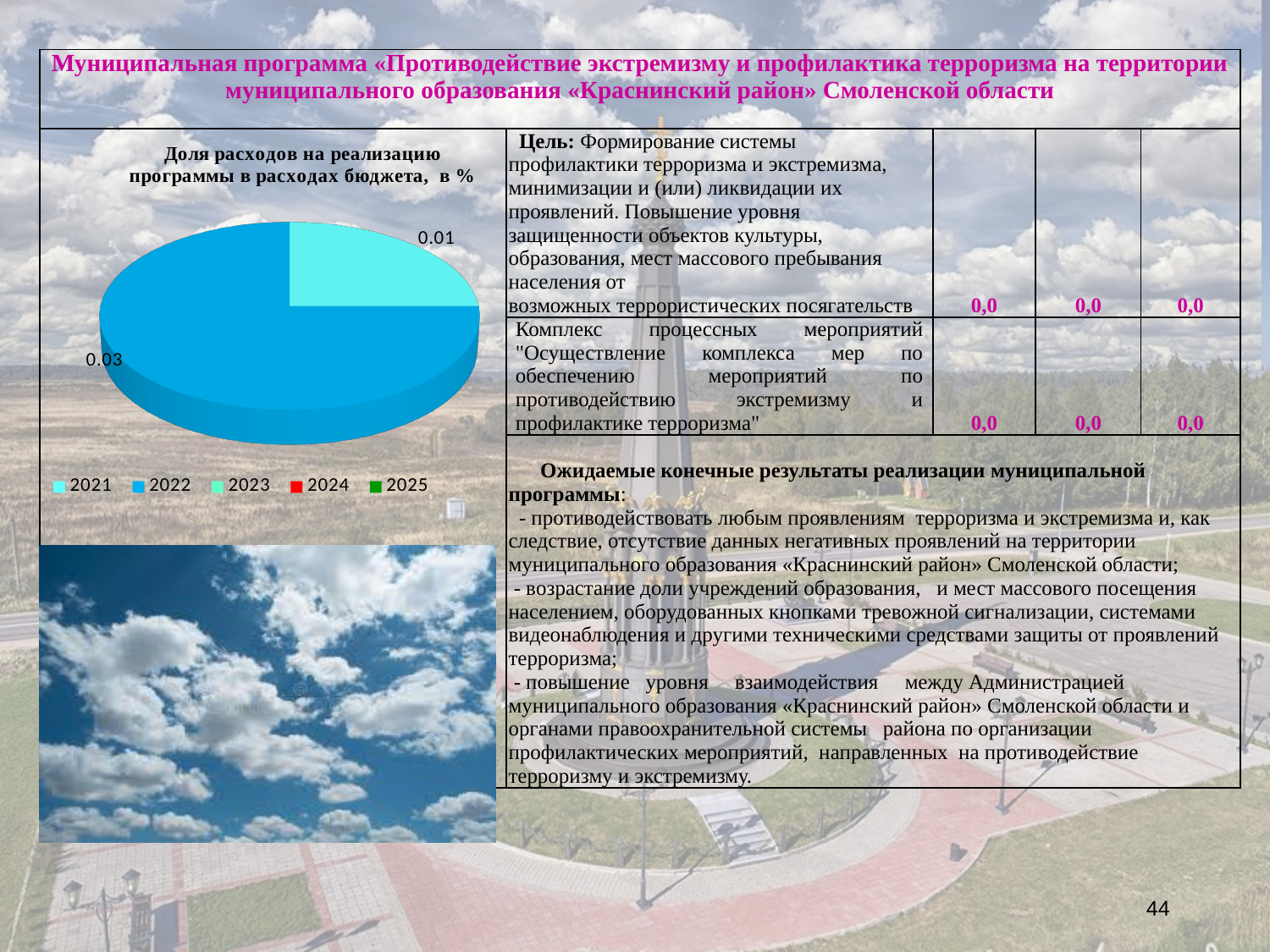
Which year has the largest slice in the pie chart? 2022 Which legend entry is shown in red in the pie chart legend? 2024 What kind of chart is shown on the slide? pie chart What value is shown for 2022 in the pie chart? 0.03 How many slices with data labels are visible in the pie chart? 2 What is the difference between the values for 2022 and 2021 in the pie chart? 0.02 Which is larger in the pie chart, the value for 2021 or the value for 2022? 2022 What share of the pie does the 2022 slice represent? 75% What value is shown for 2021 in the pie chart? 0.01 How many entries does the legend of the pie chart list? 5 What is the title of the pie chart? Доля расходов на реализацию программы в расходах бюджета, в %